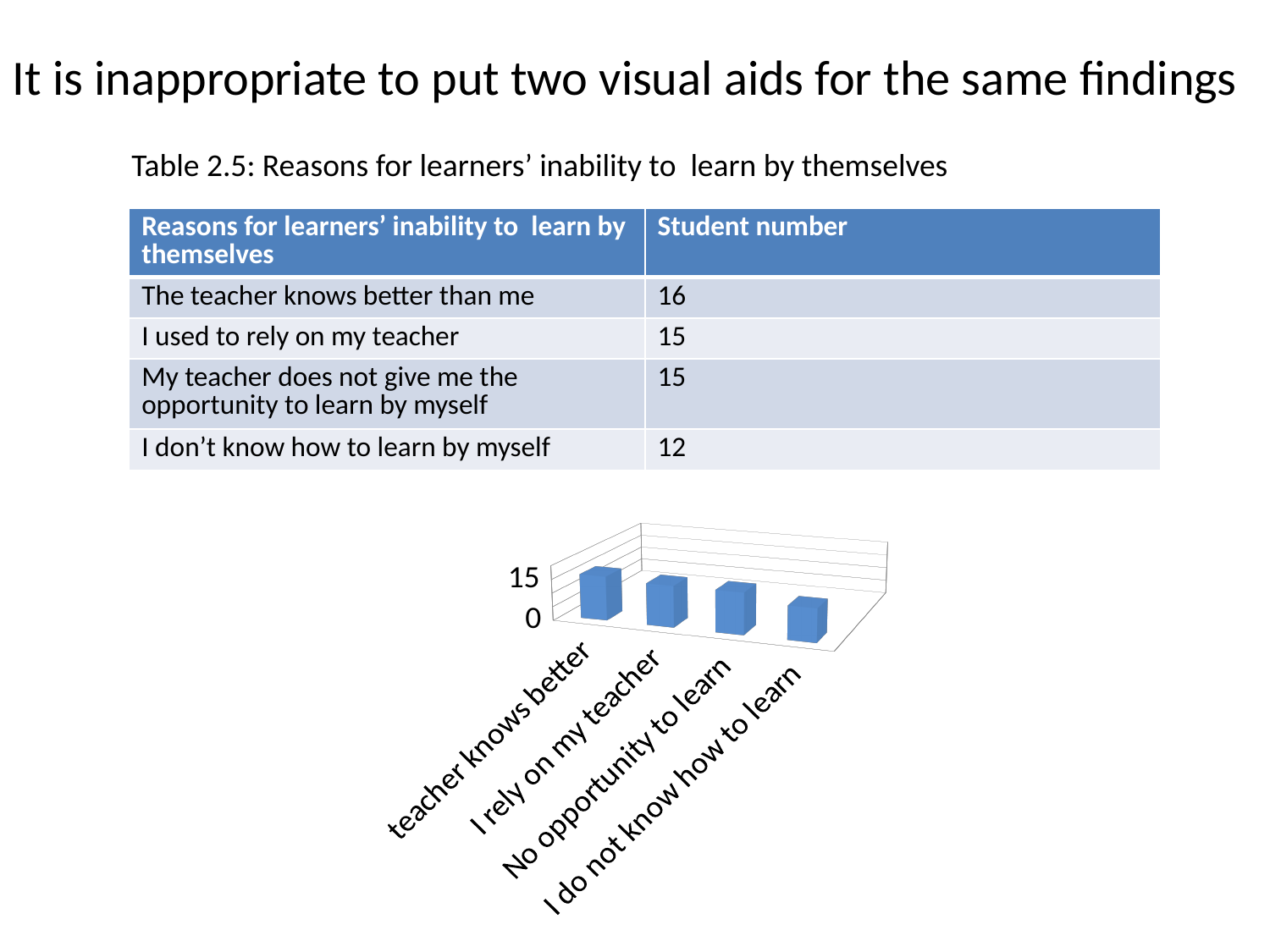
Do the bar values generally rise or fall from left to right along the x axis? fall How many categories does the bar chart show? 4 Is the value for "I do not know how to learn" greater or less than 15? less What kind of chart is shown on the slide? bar chart What are the two tick values shown on the chart's vertical axis? 0 and 15 Which is larger in the chart, the bar for "I rely on my teacher" or the bar for "I do not know how to learn"? I rely on my teacher Which is larger in the chart, the bar for "teacher knows better" or the bar for "I do not know how to learn"? teacher knows better What is the label of the first (leftmost) category on the chart's x axis? teacher knows better Which category has the lowest bar in the chart? I do not know how to learn